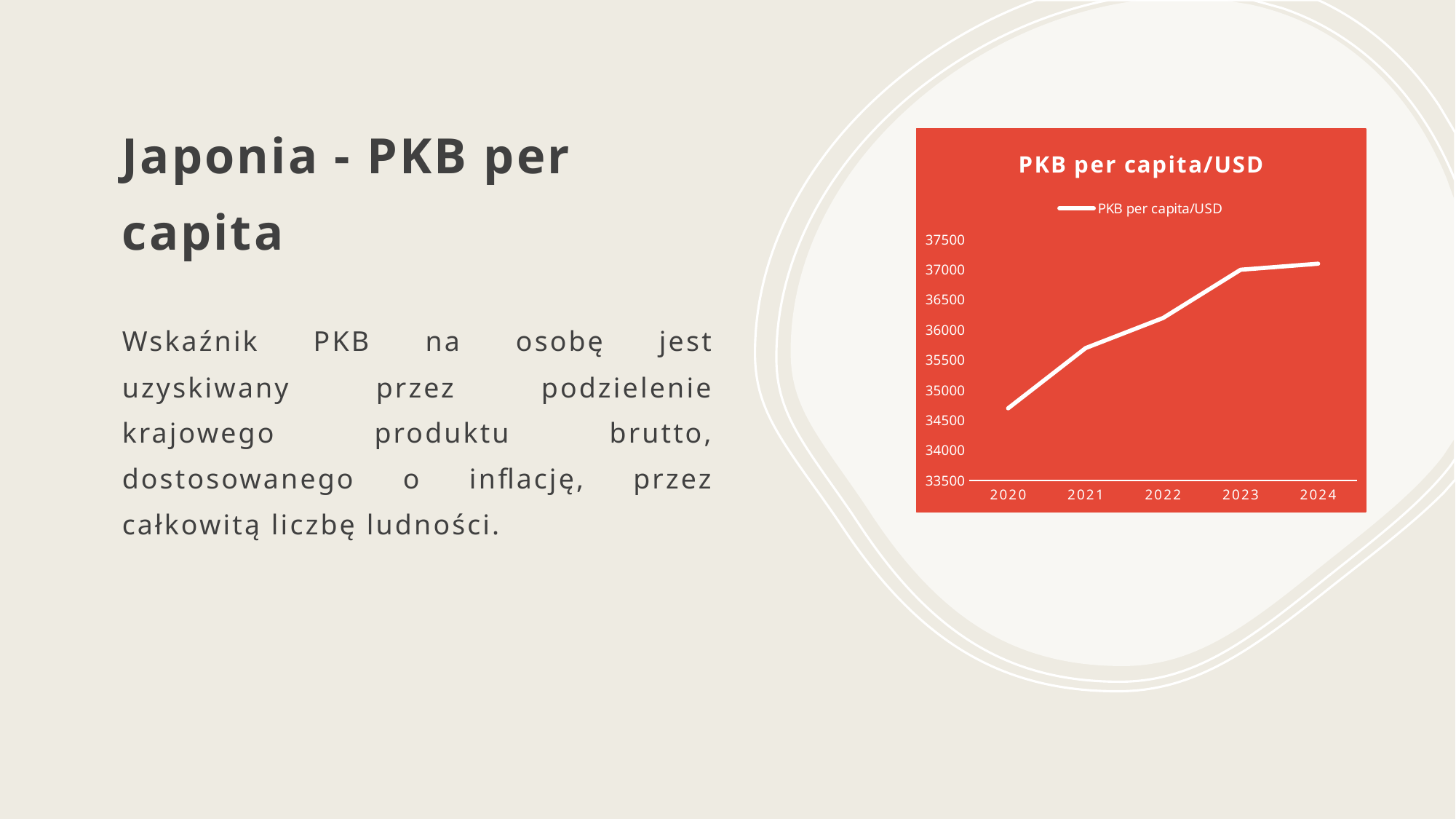
What kind of chart is shown on the slide? line chart Which year has the lowest PKB per capita value in the chart? 2020 Is the value for 2024 greater or less than 36500? greater Is the value for 2023 greater or less than 36500? greater Which year has the larger PKB per capita value, 2020 or 2022? 2022 Is the value for 2020 greater or less than 35000? less How many years are plotted on the x axis of the chart? 5 What is the title of the chart? PKB per capita/USD How many series does the chart legend list? 1 Do the PKB per capita values rise or fall from 2020 to 2024? rise